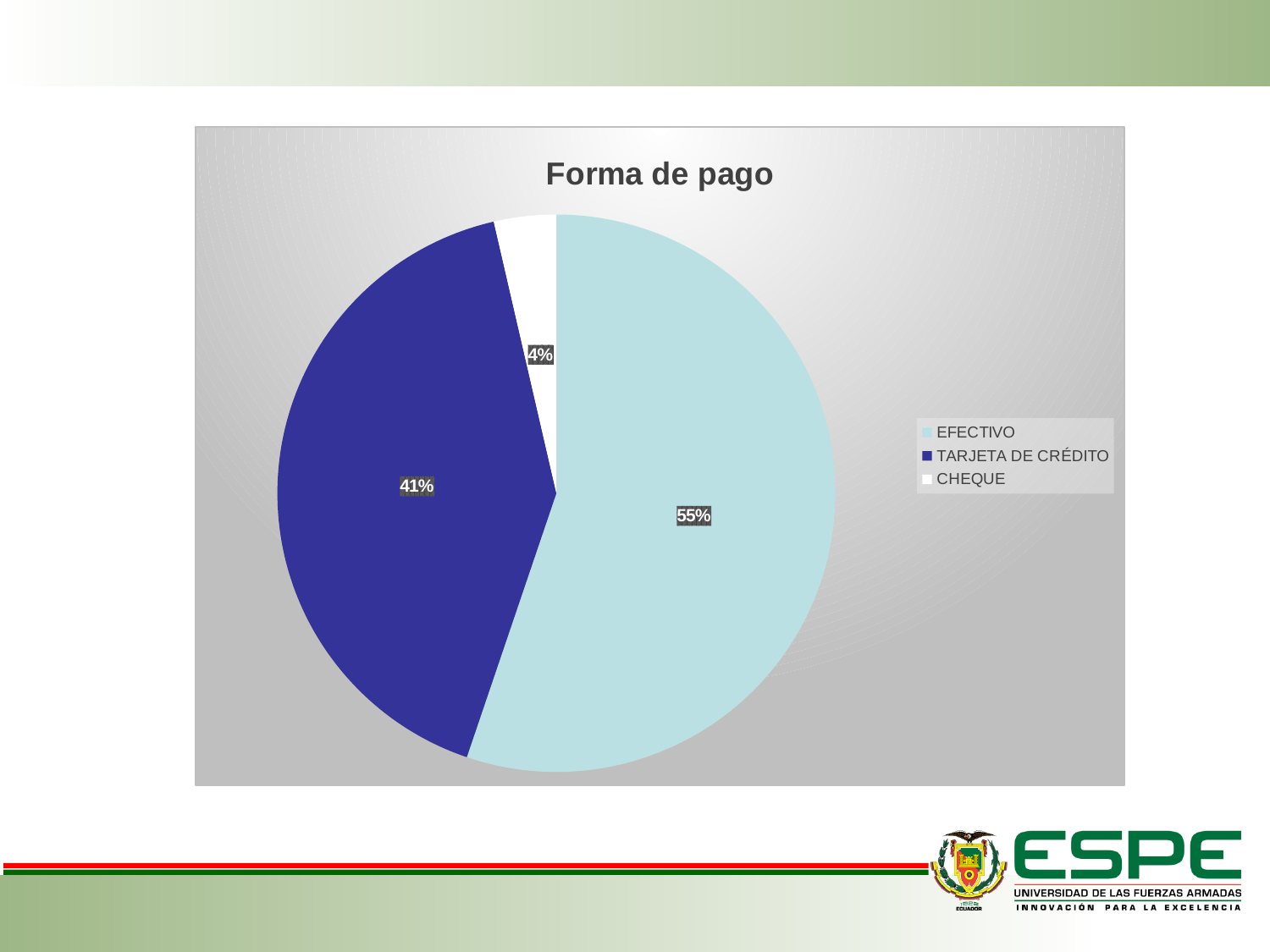
What is the difference in percentage points between EFECTIVO and TARJETA DE CRÉDITO? 14 What colour is the slice for TARJETA DE CRÉDITO? dark blue What percentage of the pie is TARJETA DE CRÉDITO? 41% Which payment method has the largest share? EFECTIVO What type of chart is shown on the slide? pie chart What percentage of the pie is CHEQUE? 4% Which is larger, the share for TARJETA DE CRÉDITO or the share for CHEQUE? TARJETA DE CRÉDITO Which payment method has the smallest share? CHEQUE What is the title of the chart? Forma de pago What percentage of the pie is EFECTIVO? 55% What is the difference in percentage points between TARJETA DE CRÉDITO and CHEQUE? 37 How many categories does the pie chart have? 3